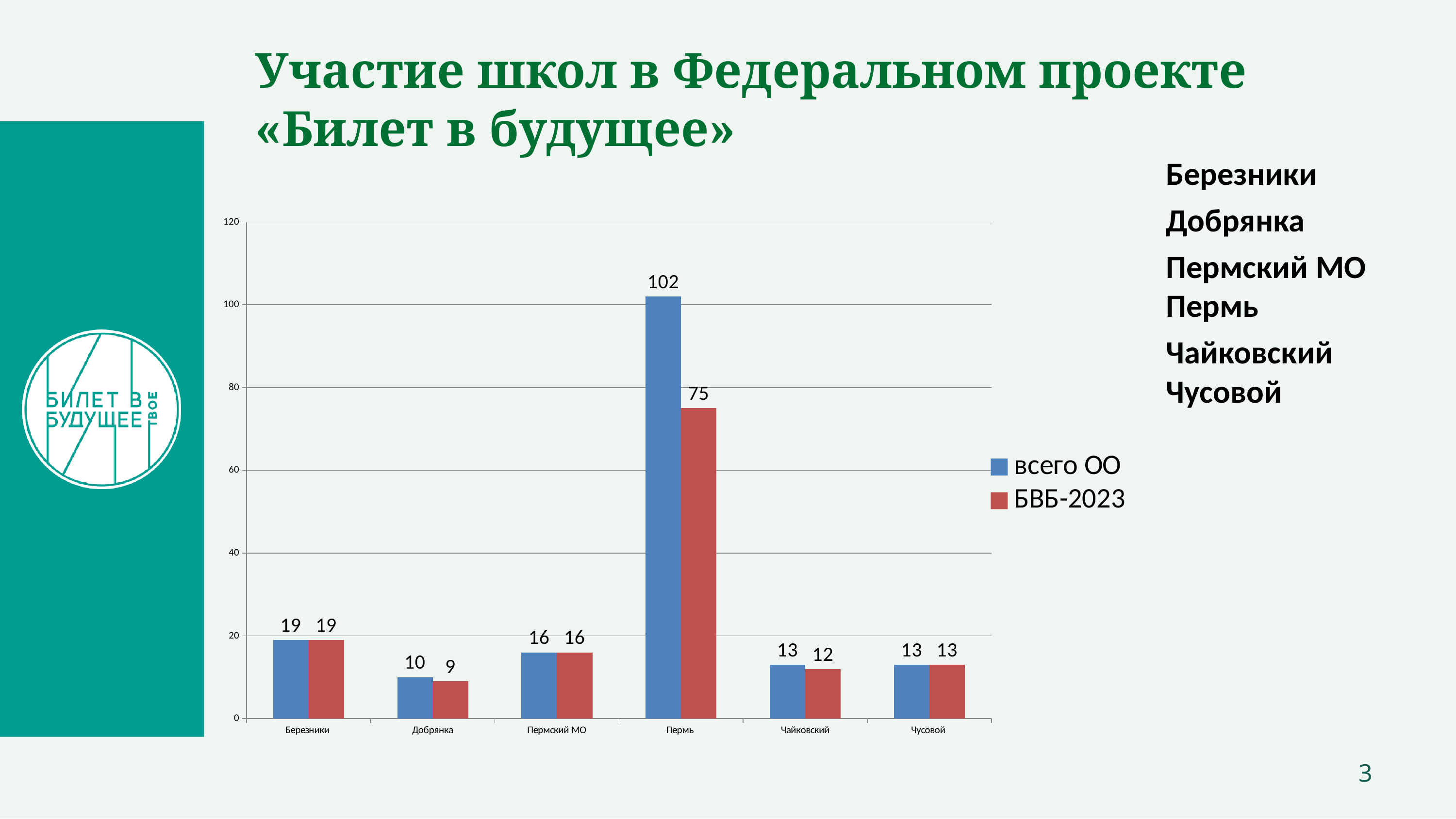
What is the value for Пермь in the всего ОО series? 102 How many categories are shown on the x axis? 6 What is the value for Добрянка in the БВБ-2023 series? 9 What is the value for Пермь in the БВБ-2023 series? 75 Which category has the lowest value in the БВБ-2023 series? Добрянка Which is larger for Чайковский: the всего ОО value or the БВБ-2023 value? всего ОО How many series does the legend list? 2 What colour are the bars for the БВБ-2023 series? red What is the value for Чайковский in the всего ОО series? 13 What is the difference between the всего ОО and БВБ-2023 values for Пермь? 27 What kind of chart is shown on the slide? bar chart Which category has the highest value in the всего ОО series? Пермь